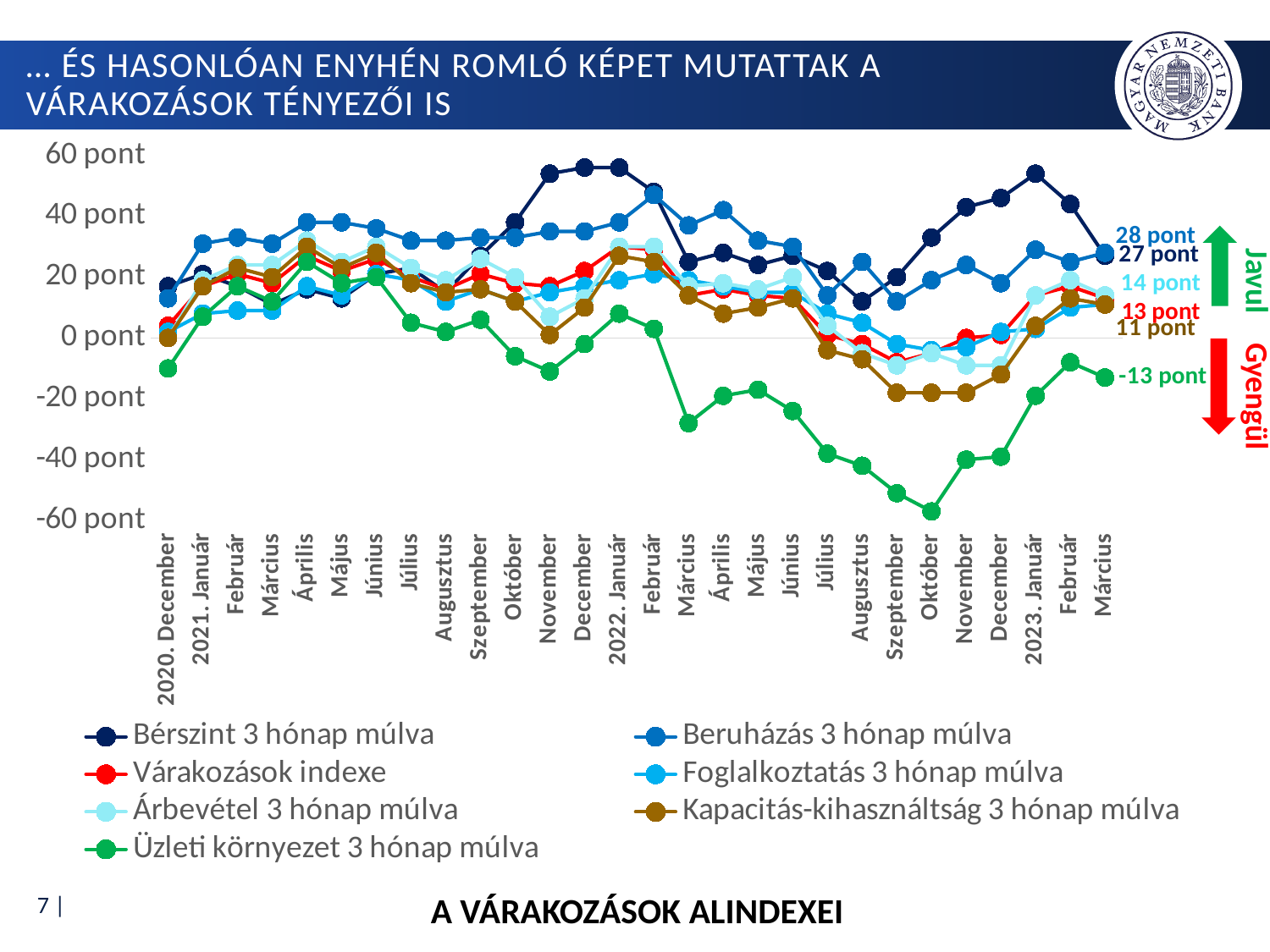
What is the value of Beruházás 3 hónap múlva in 2023 Március? 28 pont What kind of chart is shown on the slide? line chart What is the value of Bérszint 3 hónap múlva in 2023 Március? 27 pont Which series has the lowest value in 2023 Március? Üzleti környezet 3 hónap múlva Is the value for Üzleti környezet 3 hónap múlva in Október 2022 greater or less than -40 pont? less In 2023 Január, which is larger: Bérszint 3 hónap múlva or Beruházás 3 hónap múlva? Bérszint 3 hónap múlva What is the value of Üzleti környezet 3 hónap múlva in 2023 Március? -13 pont How many series does the legend list? 7 What is the difference between Beruházás 3 hónap múlva and Üzleti környezet 3 hónap múlva in 2023 Március? 41 pont What is the title shown below the chart? A VÁRAKOZÁSOK ALINDEXEI What is the value of Várakozások indexe in 2023 Március? 13 pont Is the value for Bérszint 3 hónap múlva in December 2021 greater or less than 40 pont? greater